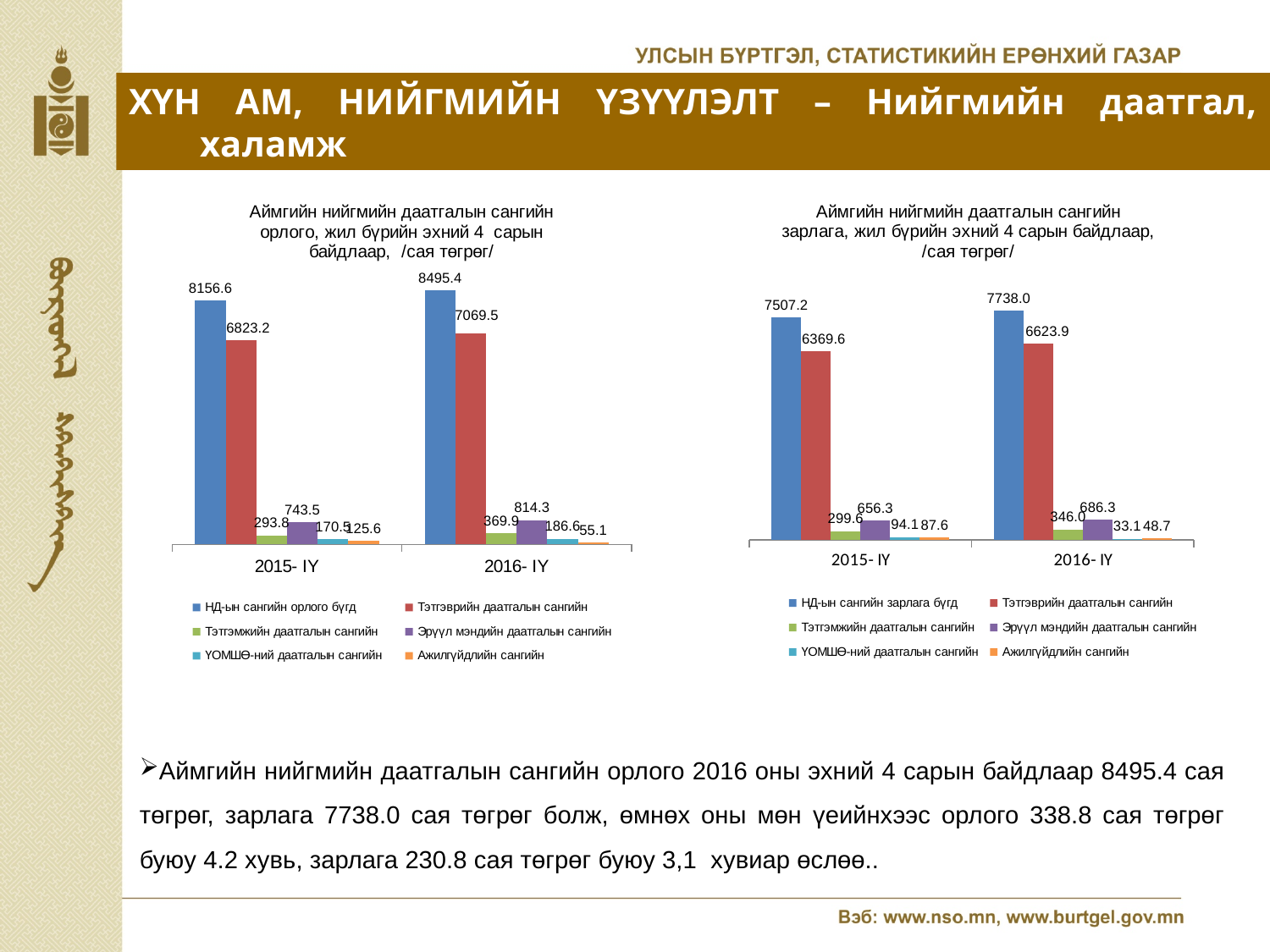
In the left chart, what is the value of Эрүүл мэндийн даатгалын сангийн for 2015-IY? 743.5 In the left chart (Аймгийн нийгмийн даатгалын сангийн орлого), what is the value of НД-ын сангийн орлого бүгд for 2016-IY? 8495.4 In the right chart, which series has the highest value for 2015-IY? НД-ын сангийн зарлага бүгд In the right chart (Аймгийн нийгмийн даатгалын сангийн зарлага), what is the value of Тэтгэврийн даатгалын сангийн for 2015-IY? 6369.6 How many series does the legend of the right chart list? 6 How many year categories are shown on the x axis of the left chart? 2 In the right chart, what is the value of ҮОМШӨ-ний даатгалын сангийн for 2016-IY? 33.1 In the right chart, what is the difference between НД-ын сангийн зарлага бүгд in 2016-IY and 2015-IY? 230.8 What type of chart is the right chart? Bar chart In the left chart, which series has the lowest value for 2016-IY? Ажилгүйдлийн сангийн In the left chart, is Тэтгэмжийн даатгалын сангийн larger in 2015-IY or 2016-IY? 2016-IY In the left chart, by how much did НД-ын сангийн орлого бүгд increase from 2015-IY to 2016-IY? 338.8